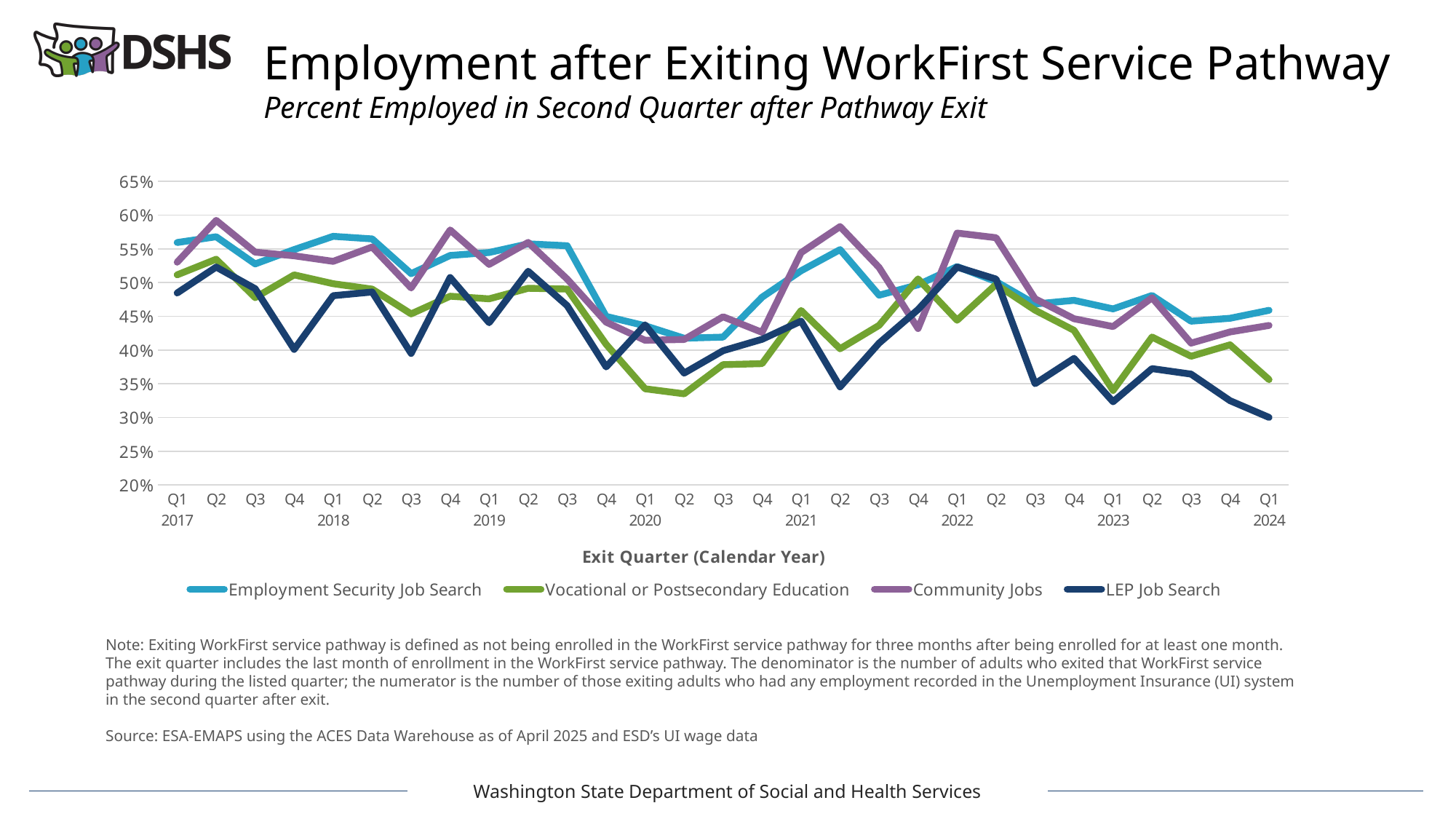
Is the value for LEP Job Search in Q1 2024 greater or less than 35%? less In Q2 2020, which is larger: Community Jobs or Vocational or Postsecondary Education? Community Jobs Is the value for Vocational or Postsecondary Education in Q2 2020 greater or less than 35%? less Is the value for Community Jobs in Q2 2017 greater or less than 55%? greater Does the LEP Job Search line rise or fall from Q1 2022 to Q1 2024? Fall What is the title of the x axis? Exit Quarter (Calendar Year) How many exit quarters are plotted along the x axis? 29 In Q1 2024, which is larger: Employment Security Job Search or LEP Job Search? Employment Security Job Search What kind of chart is shown on the slide? Line chart Which series has the lowest value in Q1 2024? LEP Job Search How many series does the legend list? 4